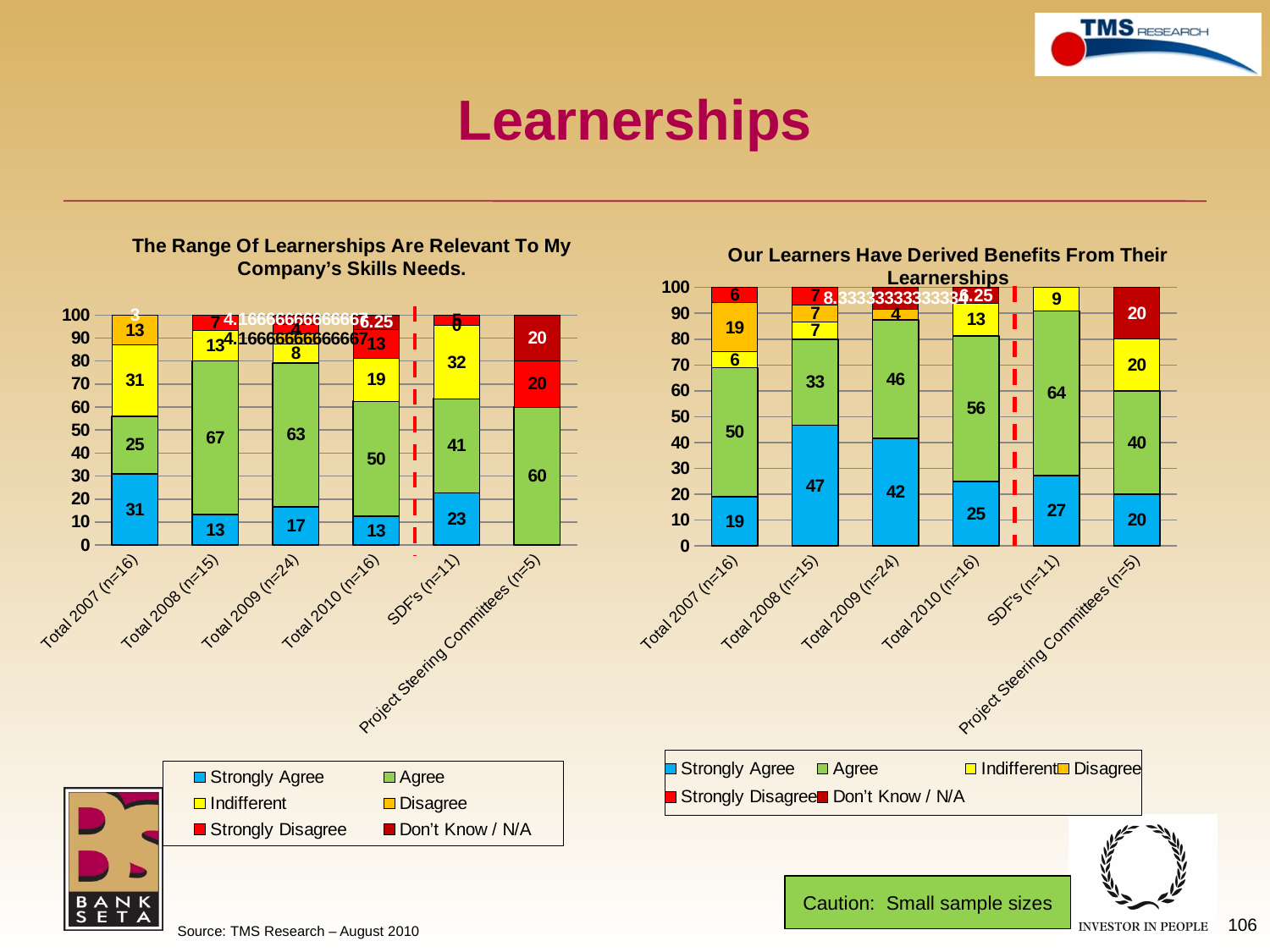
In the chart 'Our Learners Have Derived Benefits From Their Learnerships', which category has the highest Agree value? SDF's (n=11) In the chart 'Our Learners Have Derived Benefits From Their Learnerships', what is the Strongly Agree value for Total 2008 (n=15)? 47 In the chart 'The Range Of Learnerships Are Relevant To My Company's Skills Needs', what is the Agree value for Project Steering Committees (n=5)? 60 How many series does the legend of the chart 'The Range Of Learnerships Are Relevant To My Company's Skills Needs' list? 6 In the chart 'Our Learners Have Derived Benefits From Their Learnerships', what is the difference between the Agree values for Total 2010 (n=16) and Total 2008 (n=15)? 23 In the chart 'Our Learners Have Derived Benefits From Their Learnerships', what is the Agree value for SDF's (n=11)? 64 In the chart 'The Range Of Learnerships Are Relevant To My Company's Skills Needs', which category has the lowest Agree value? Total 2007 (n=16) In the chart 'The Range Of Learnerships Are Relevant To My Company's Skills Needs', what is the Agree value for Total 2008 (n=15)? 67 How many categories are shown on the x axis of the chart 'Our Learners Have Derived Benefits From Their Learnerships'? 6 In the chart 'The Range Of Learnerships Are Relevant To My Company's Skills Needs', what is the Strongly Agree value for Total 2007 (n=16)? 31 What kind of chart is 'Our Learners Have Derived Benefits From Their Learnerships'? Stacked bar chart In the chart 'The Range Of Learnerships Are Relevant To My Company's Skills Needs', is the Strongly Agree value larger for SDF's (n=11) or for Total 2010 (n=16)? SDF's (n=11)